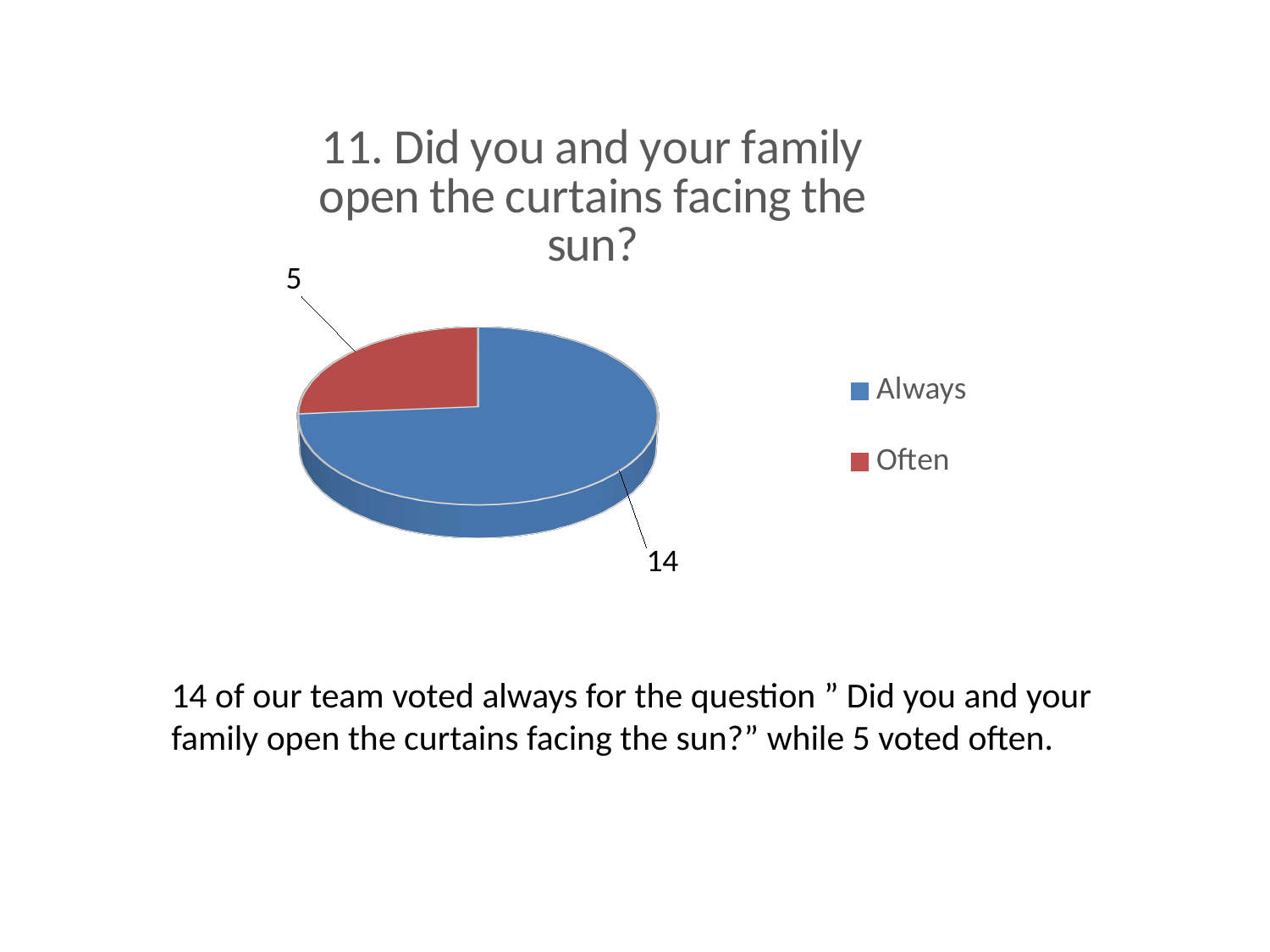
What colour is the Often slice in the pie chart? Red What value is shown for the Often slice? 5 Which category has the largest slice of the pie? Always What is the title of the chart? 11. Did you and your family open the curtains facing the sun? How many slices does the pie chart have? 2 What is the difference between the Always and Often values? 9 How many entries does the legend list? 2 What kind of chart is shown on the slide? Pie chart What value is shown for the Always slice? 14 Which category has the smallest slice of the pie? Often Which is larger, the value for Always or the value for Often? Always What is the total of all slices in the pie chart? 19